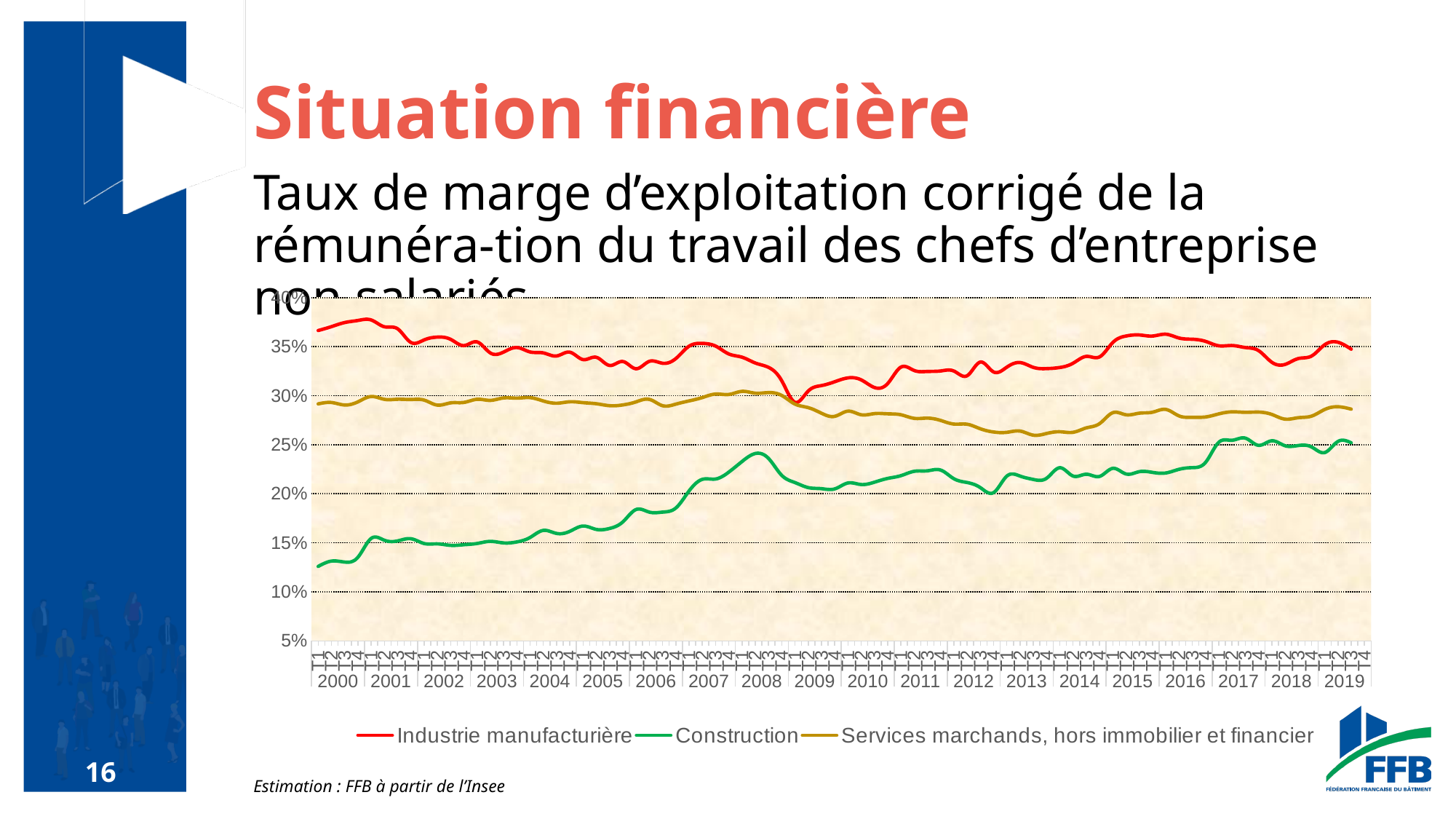
What kind of chart is shown on the slide? line chart Which series is plotted in green? Construction Does the Construction series rise or fall overall from 2000 to 2019? rise Is the value for Construction in 2000 T1 greater or less than 15%? less Is the value for Construction in 2008 T2 greater or less than 20%? greater How many series does the legend list? 3 Is the value for Industrie manufacturière in 2001 T1 greater or less than 35%? greater In 2019 T3, which is larger: Construction or Services marchands, hors immobilier et financier? Services marchands, hors immobilier et financier Which series has the highest values across the whole period? Industrie manufacturière Which series has the lowest values across the whole period? Construction Which series is plotted in red? Industrie manufacturière